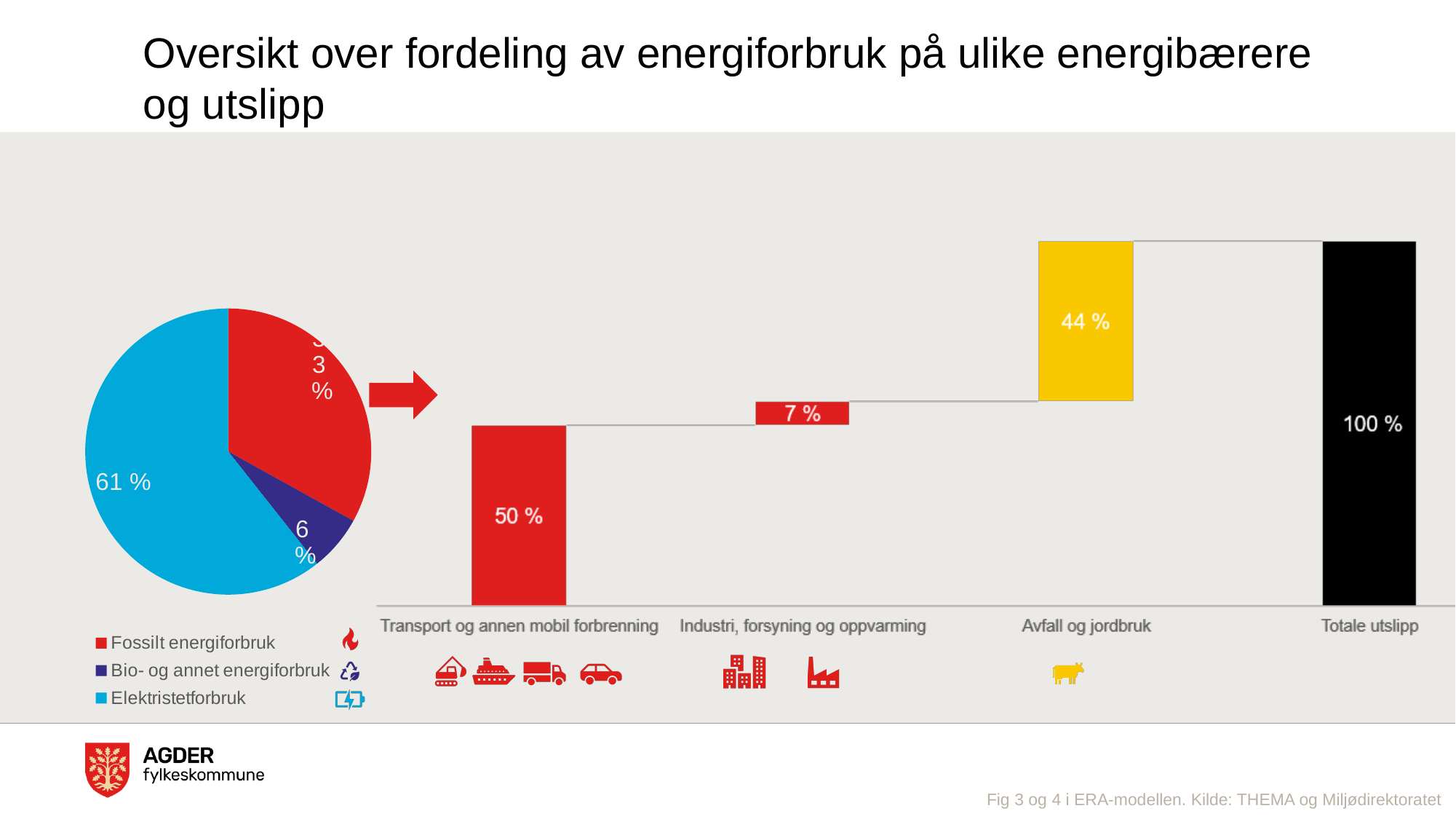
In the pie chart on the left, which category has the largest slice? Elektristetforbruk In the bar chart on the right, what value is shown for Industri, forsyning og oppvarming? 7 % In the bar chart on the right, which category has the lowest value? Industri, forsyning og oppvarming In the pie chart on the left, what share is shown for Bio- og annet energiforbruk? 6 % What kind of chart is the chart on the left of the slide? Pie chart In the pie chart on the left, what share is shown for Elektristetforbruk? 61 % In the pie chart on the left, which category has the smallest slice? Bio- og annet energiforbruk How many categories are shown on the x axis of the bar chart on the right? 4 In the bar chart on the right, what is the difference between the values for Transport og annen mobil forbrenning and Avfall og jordbruk? 6 % In the bar chart on the right, what value is shown for Transport og annen mobil forbrenning? 50 % How many entries does the legend of the pie chart on the left list? 3 In the bar chart on the right, what value is shown for Avfall og jordbruk? 44 %